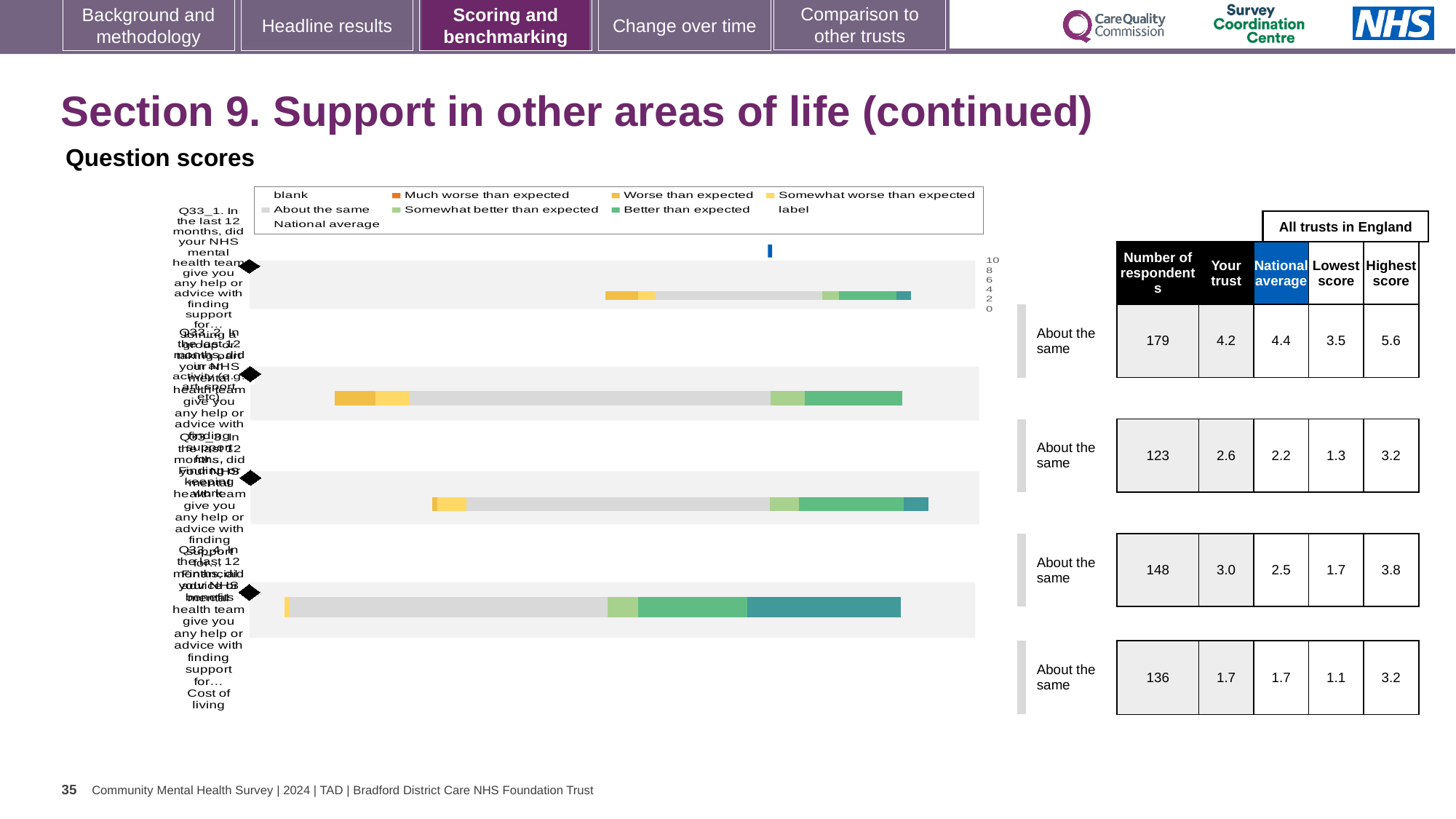
How many entries does the chart legend list? 9 In the table beside the chart, what is the 'Your trust' score for the second row (Q33_2)? 2.6 In the table beside the chart, which row has the highest number of respondents? The first row (Q33_1), 179 What comparison label is shown next to each of the four bars in the chart? About the same In the table beside the chart, what is the difference between the highest score and the lowest score for the first row (Q33_1)? 2.1 In the table beside the chart, for the third row (Q33_3), is the 'Your trust' score or the 'National average' larger? Your trust (3.0) How many question bars are plotted in the chart? 4 What kind of chart is shown on the slide? Stacked bar chart Which legend entry is shown in grey in the chart? About the same In the table beside the chart, which row has the lowest 'Your trust' score? The fourth row (Q33_4), 1.7 In the table beside the chart, what is the number of respondents for the first row (Q33_1)? 179